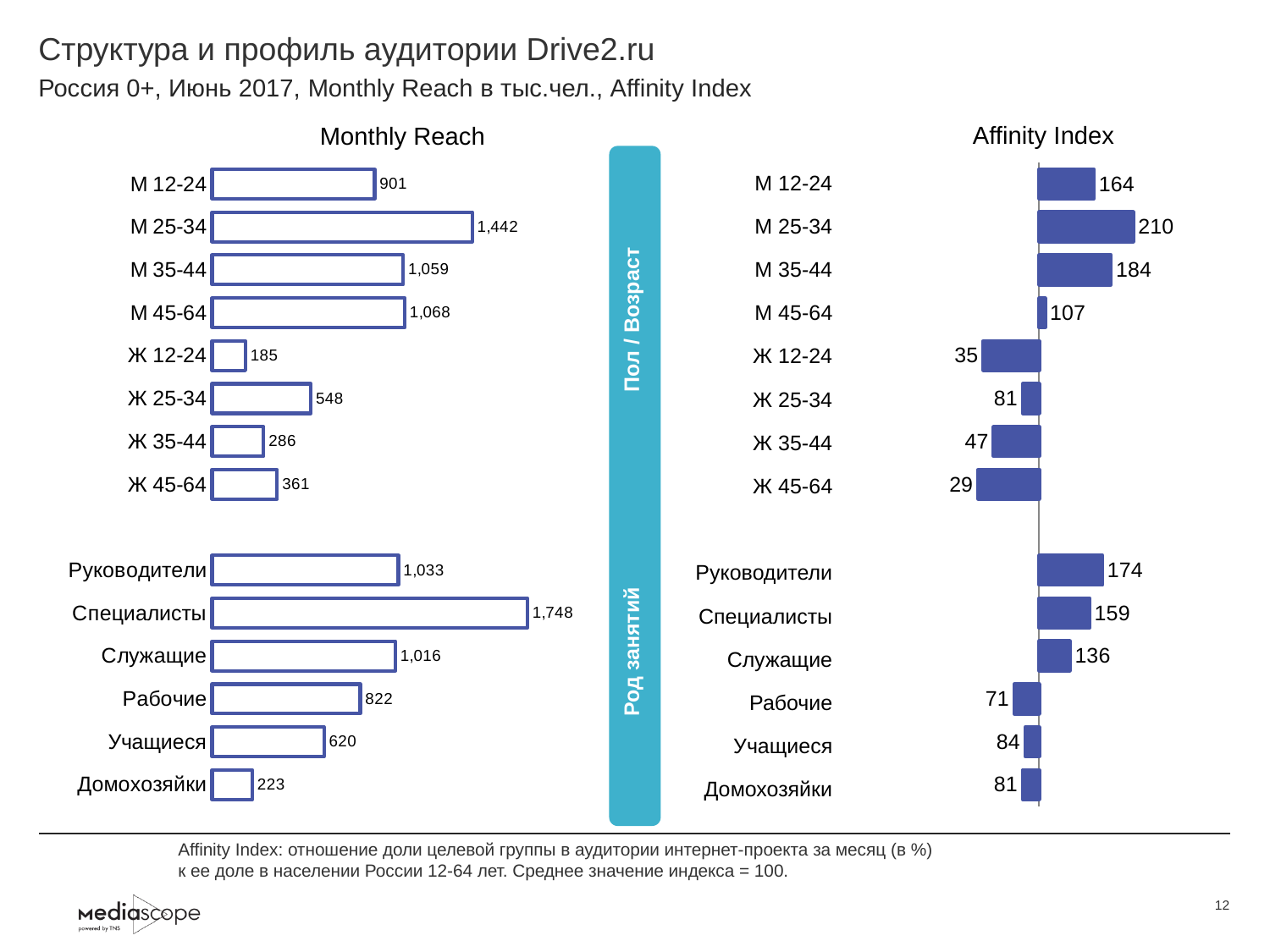
In the Affinity Index chart, what is the value for Служащие? 136 In the Monthly Reach chart, which category has the highest value? Специалисты In the Monthly Reach chart, what is the value for Домохозяйки? 223 In the Monthly Reach chart, which is larger: Ж 25-34 or Ж 45-64? Ж 25-34 In the Affinity Index chart, what is the difference between М 12-24 and Ж 12-24? 129 In the Monthly Reach chart, what is the difference between Специалисты and Руководители? 715 In the Monthly Reach chart, what is the value for М 25-34? 1,442 How many categories are shown in the Monthly Reach chart? 14 In the Affinity Index chart, what is the value for Руководители? 174 What type of chart is the Affinity Index chart? Bar chart In the Affinity Index chart, which is larger: М 25-34 or М 35-44? М 25-34 In the Affinity Index chart, which category has the lowest value? Ж 45-64